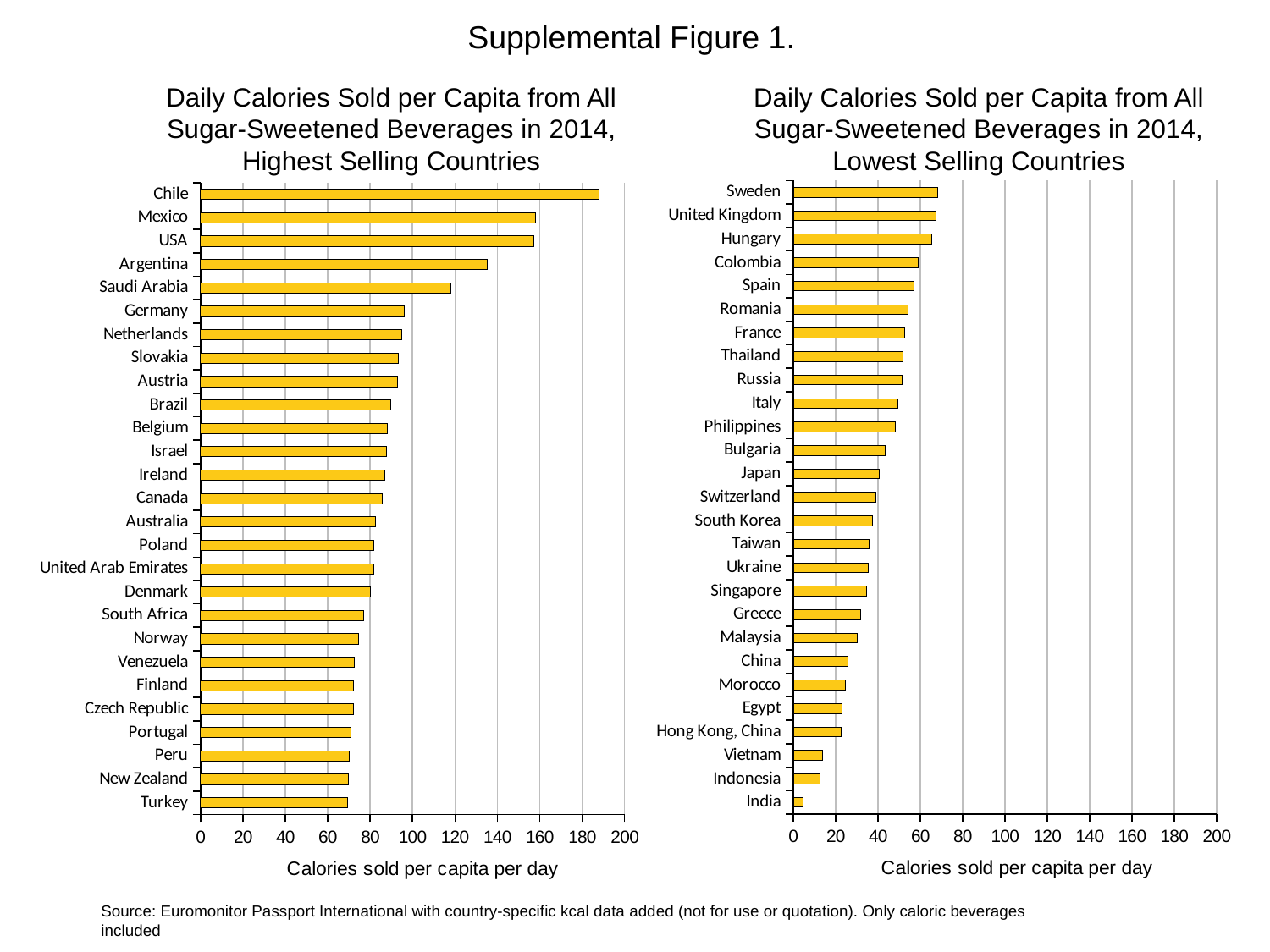
In the right chart, 'Lowest Selling Countries', which country has the lowest daily calories sold per capita? India In the right chart, 'Lowest Selling Countries', which country has the highest daily calories sold per capita? Sweden In the right chart, 'Lowest Selling Countries', is the value for Vietnam greater or less than 20? less In the left chart, 'Highest Selling Countries', which has the larger value, Chile or Mexico? Chile What is the x-axis label of the left chart, 'Highest Selling Countries'? Calories sold per capita per day In the left chart, 'Highest Selling Countries', which country has the highest daily calories sold per capita? Chile In the right chart, 'Lowest Selling Countries', is the value for Sweden greater or less than 80? less In the left chart, 'Highest Selling Countries', is the value for Chile greater or less than 180? greater How many countries are shown in the right chart, 'Lowest Selling Countries'? 27 What type of chart is used in the left chart, 'Highest Selling Countries'? bar chart In the left chart, 'Highest Selling Countries', which country has the lowest daily calories sold per capita? Turkey